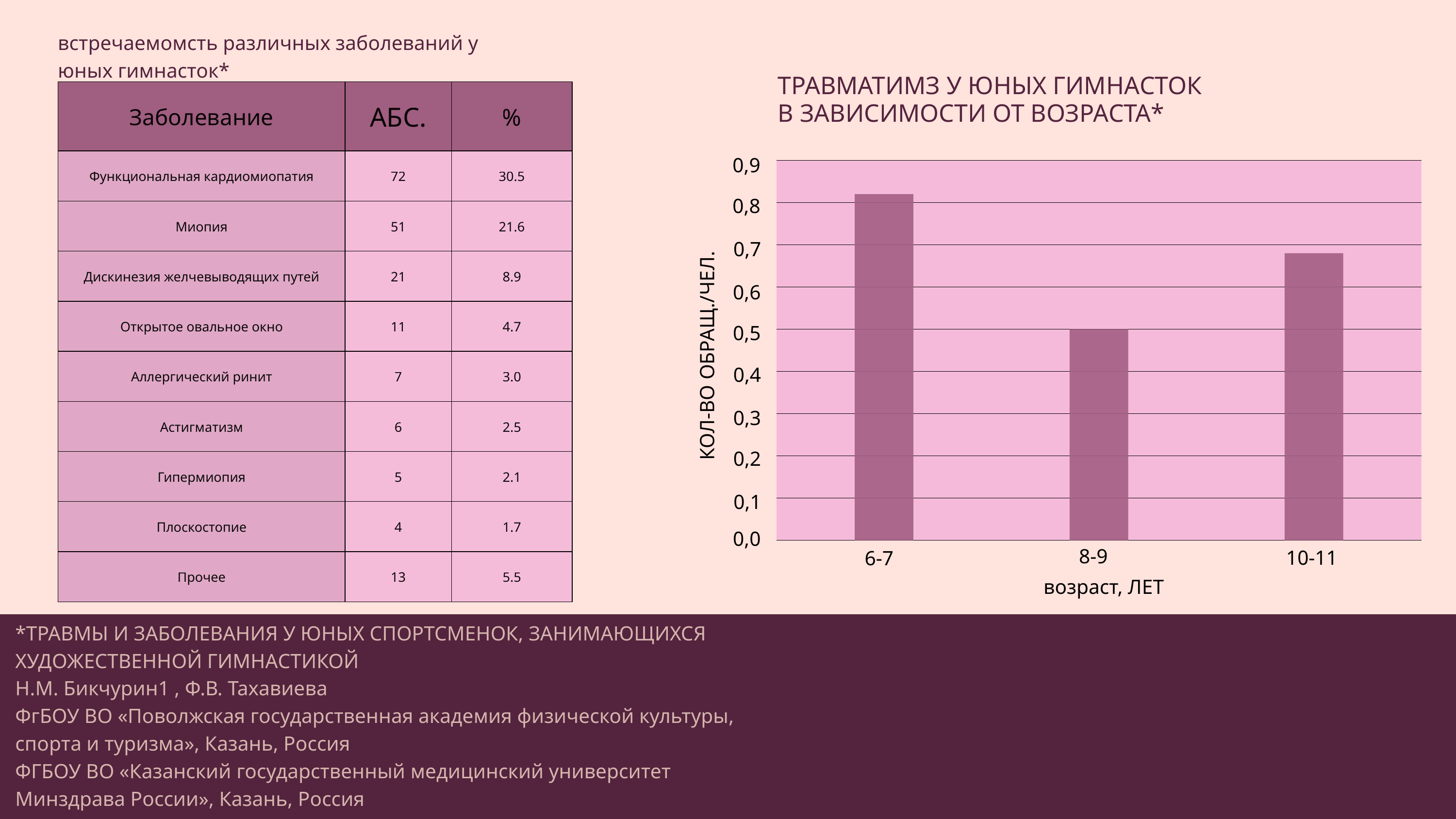
In the bar chart, is the value for the 6-7 age group greater or less than 0,8? greater What is the label of the x axis of the bar chart? возраст, ЛЕТ In the bar chart, which age group has a larger value: 6-7 or 10-11? 6-7 Which age group has the lowest value in the bar chart? 8-9 In the bar chart, is the value for the 10-11 age group greater or less than 0,6? greater What is the title of the bar chart? ТРАВМАТИМЗ У ЮНЫХ ГИМНАСТОК В ЗАВИСИМОСТИ ОТ ВОЗРАСТА* Which age group has the highest value in the bar chart? 6-7 In the bar chart, which age group has a larger value: 8-9 or 10-11? 10-11 What kind of chart is shown on the right side of the slide? bar chart How many age groups are shown on the x axis of the bar chart? 3 In the bar chart, is the value for the 10-11 age group greater or less than 0,7? less What is the value for the 8-9 age group in the bar chart? 0,5